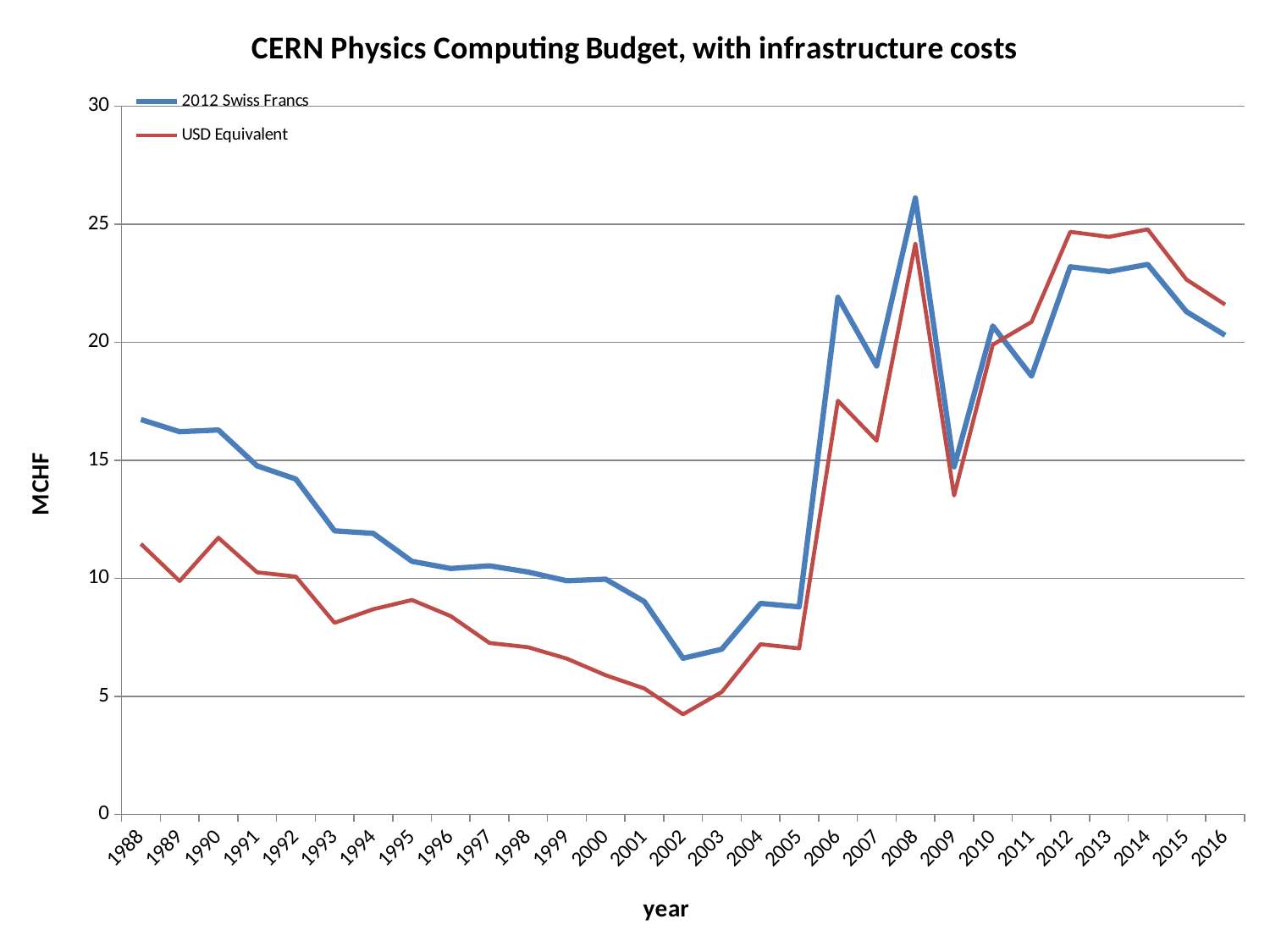
In which year does the 2012 Swiss Francs series reach its highest value? 2008 Is the USD Equivalent value for 2009 greater or less than 15? less In which year does the USD Equivalent series reach its lowest value? 2002 In 2014, which series has the larger value, 2012 Swiss Francs or USD Equivalent? USD Equivalent How many years are plotted along the x axis? 29 Is the 2012 Swiss Francs value for 2008 greater or less than 25? greater Does the 2012 Swiss Francs series generally rise or fall from 1988 to 2002? fall In which year does the 2012 Swiss Francs series reach its lowest value? 2002 What kind of chart is shown on the slide? line chart How many series does the legend list? 2 In 1988, which series has the larger value, 2012 Swiss Francs or USD Equivalent? 2012 Swiss Francs Is the USD Equivalent value for 2002 greater or less than 5? less